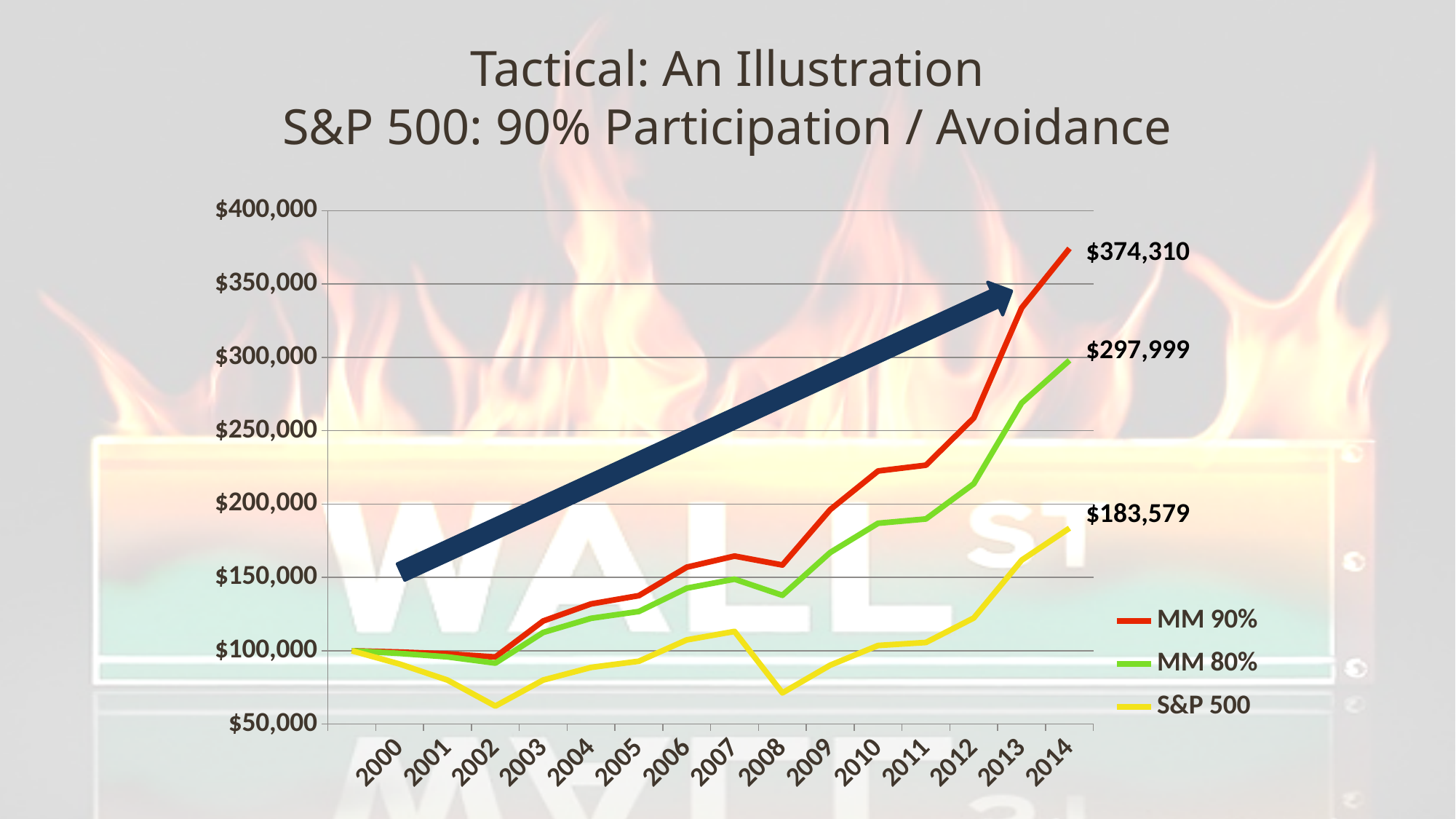
How many series does the legend list? 3 What is the difference between the MM 90% and MM 80% values in 2014? $76,311 Is the value for MM 90% in 2013 greater or less than $300,000? greater What is the value of the S&P 500 series in 2014? $183,579 Is the value for the S&P 500 in 2008 greater or less than $100,000? less What is the value of the MM 90% series in 2014? $374,310 Which series has the lowest value in 2014? S&P 500 What is the difference between the MM 90% and S&P 500 values in 2014? $190,731 How many years are shown on the x axis? 15 What is the value of the MM 80% series in 2014? $297,999 What kind of chart is shown on the slide? line chart Which series has the highest value in 2014? MM 90%